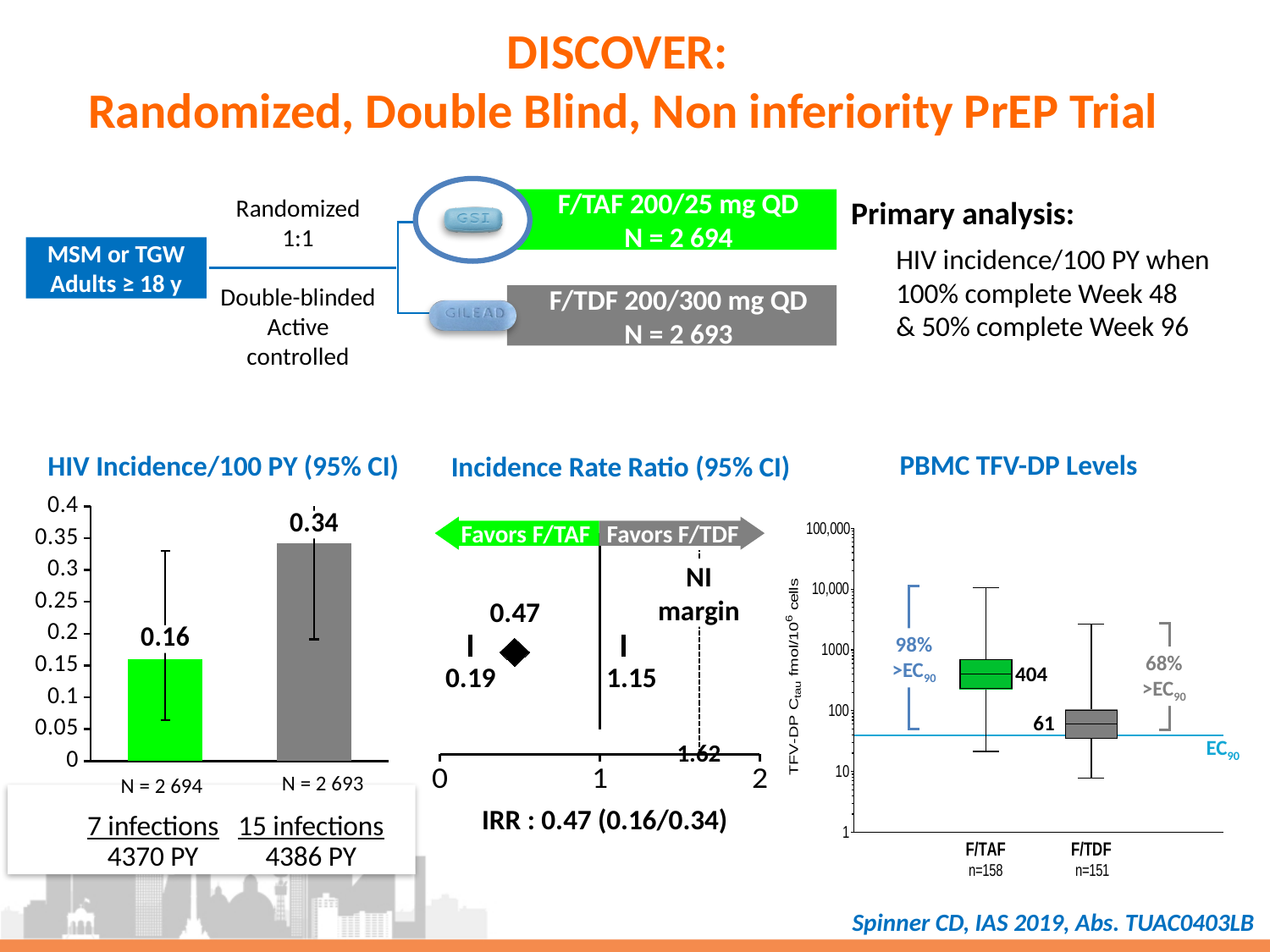
What kind of chart is the HIV Incidence/100 PY chart? bar chart In the HIV Incidence/100 PY chart, how many bars are plotted? 2 In the HIV Incidence/100 PY chart, what is the value of the gray bar labelled N = 2 693? 0.34 In the PBMC TFV-DP Levels chart, what is the median value labelled for F/TAF? 404 In the HIV Incidence/100 PY chart, is the value for N = 2 693 greater or less than 0.3? greater In the HIV Incidence/100 PY chart, which bar is higher, N = 2 694 or N = 2 693? N = 2 693 In the HIV Incidence/100 PY chart, what is the value of the green bar labelled N = 2 694? 0.16 In the Incidence Rate Ratio chart, what is the upper bound of the 95% CI shown next to the diamond? 1.15 In the Incidence Rate Ratio chart, what is the point estimate of the IRR? 0.47 In the PBMC TFV-DP Levels chart, what is the median value labelled for F/TDF? 61 In the Incidence Rate Ratio chart, at what value is the NI margin drawn? 1.62 In the HIV Incidence/100 PY chart, what is the difference between the two bar values? 0.18